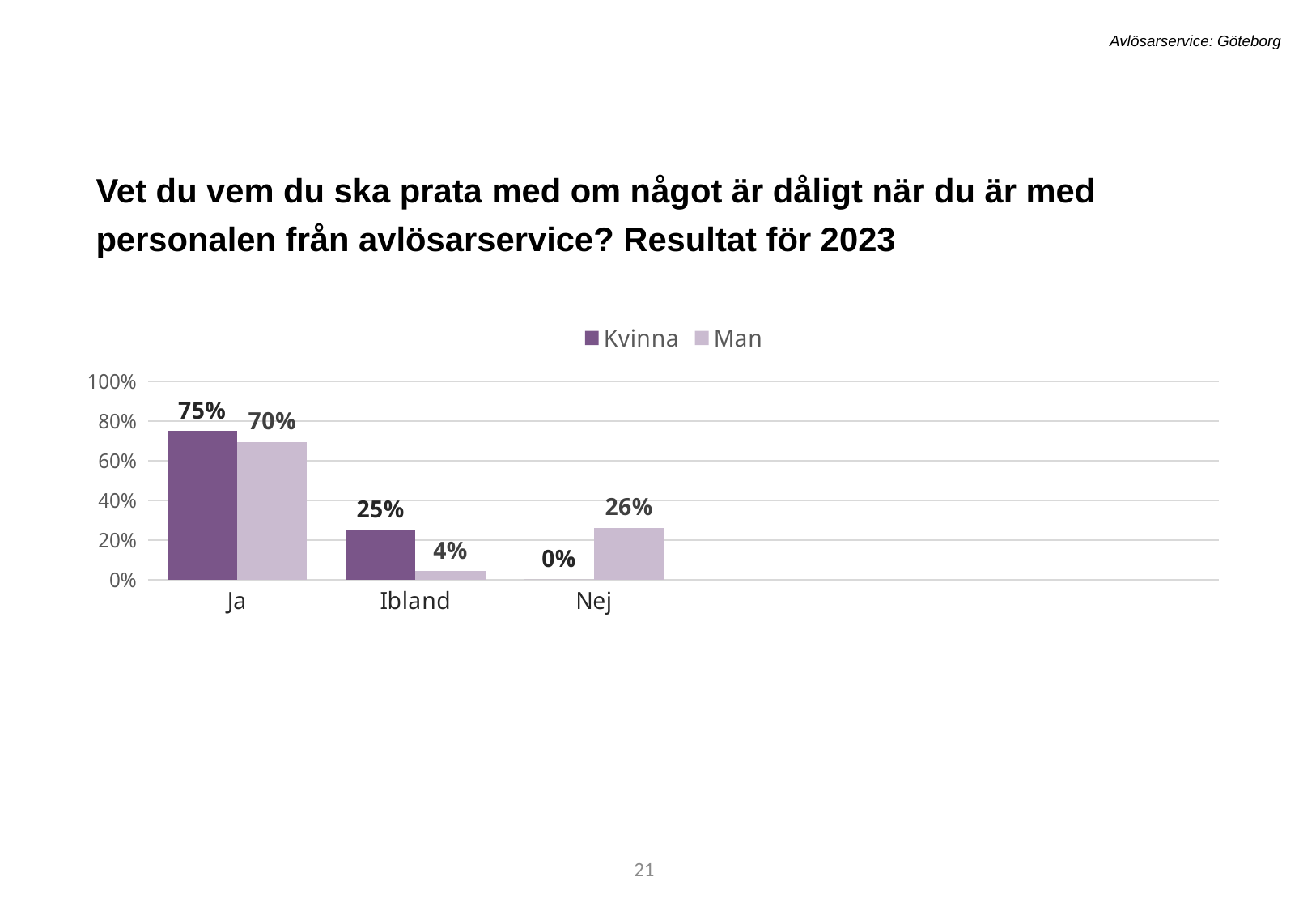
Which category has the lowest value for the Man series? Ibland What is the value for Kvinna in the Ja category? 75% What is the difference between the Kvinna and Man values in the Ibland category? 21% In the Nej category, which series has the larger value, Kvinna or Man? Man What is the value for Man in the Nej category? 26% What is the difference between the Kvinna and Man values in the Ja category? 5% What kind of chart is shown on the slide? Bar chart Which series is shown in the darker purple colour? Kvinna How many series does the legend list? 2 How many categories are shown on the x axis? 3 Which category has the highest value for the Kvinna series? Ja What is the value for Man in the Ibland category? 4%